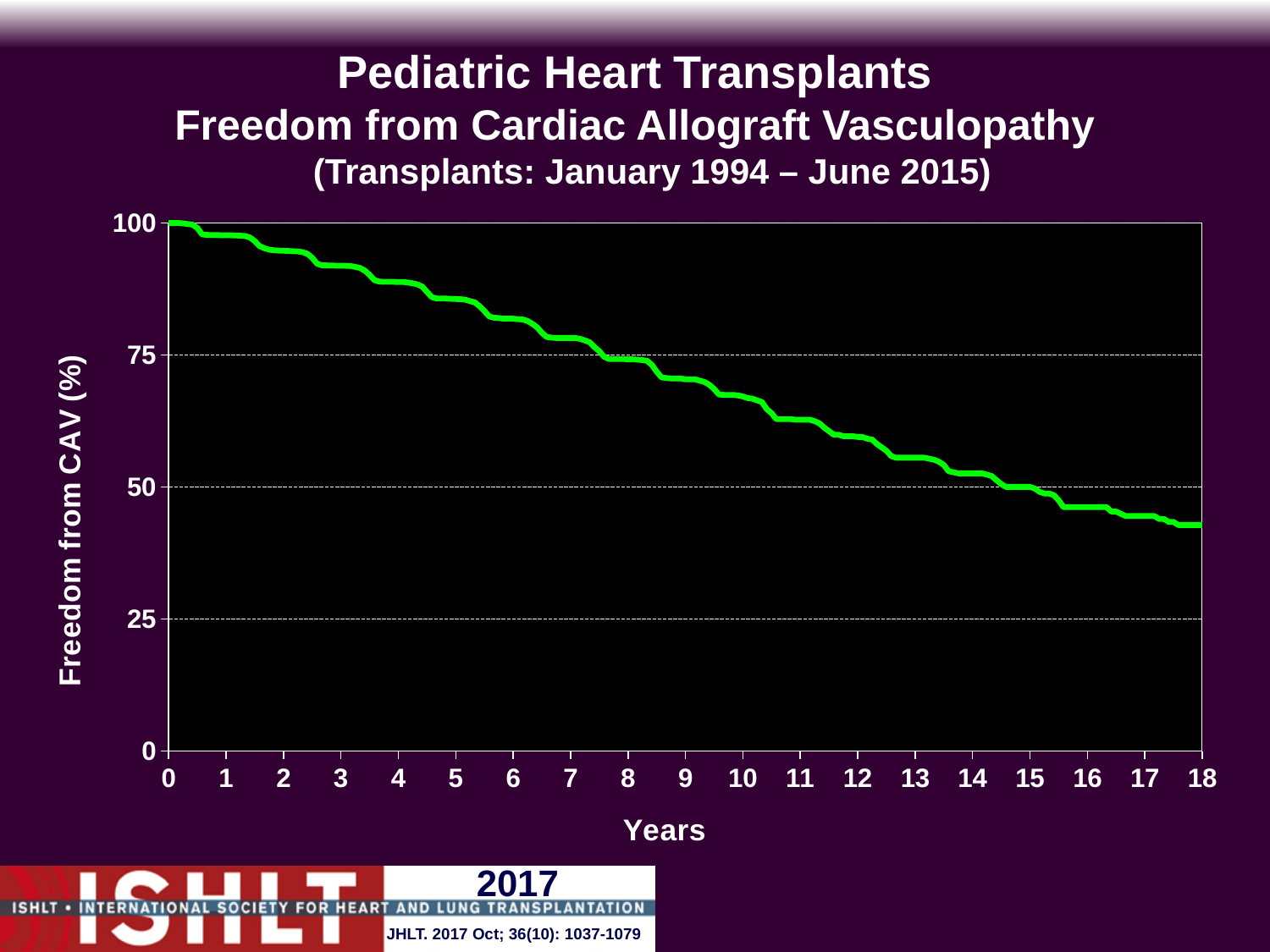
Does the freedom from CAV curve rise or fall as years increase? fall Is the freedom from CAV value at year 10 greater or less than 75? less Is the freedom from CAV value at year 5 greater or less than 75? greater What is the label of the y axis? Freedom from CAV (%) Is the freedom from CAV value at year 2 greater or less than 75? greater What kind of chart is shown on the slide? line chart What is the freedom from CAV value at year 0? 100 Which year has the higher freedom from CAV value, year 3 or year 13? year 3 What is the label of the x axis? Years